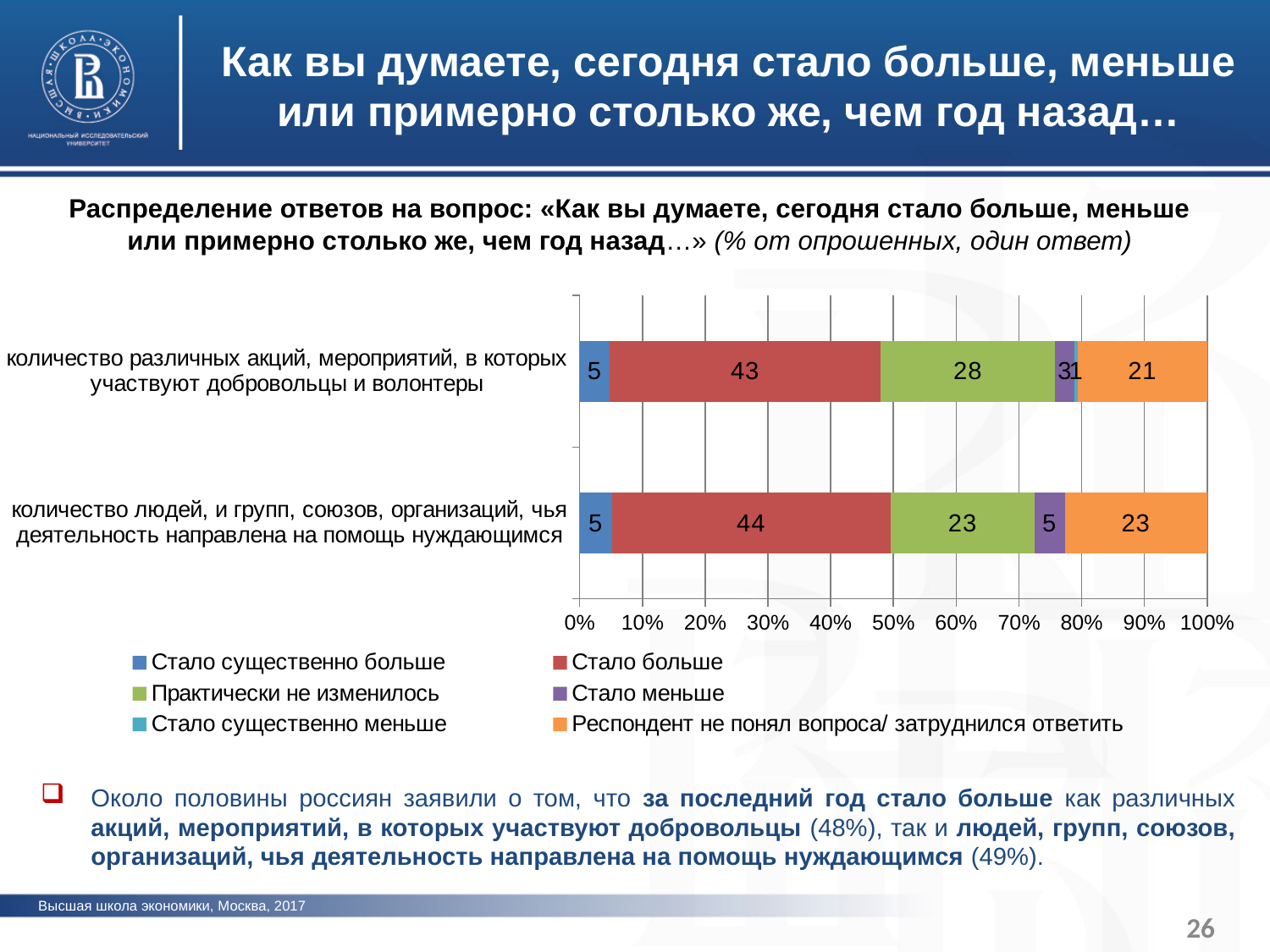
What is the value for «Стало меньше» for the category «количество людей, и групп, союзов, организаций, чья деятельность направлена на помощь нуждающимся»? 5 What is the value for «Стало существенно больше» for the category «количество людей, и групп, союзов, организаций, чья деятельность направлена на помощь нуждающимся»? 5 What is the difference between the «Практически не изменилось» values for the two categories? 5 What is the value for «Стало больше» for the category «количество различных акций, мероприятий, в которых участвуют добровольцы и волонтеры»? 43 What is the value for «Практически не изменилось» for the category «количество различных акций, мероприятий, в которых участвуют добровольцы и волонтеры»? 28 What is the value for «Практически не изменилось» for the category «количество людей, и групп, союзов, организаций, чья деятельность направлена на помощь нуждающимся»? 23 What is the value for «Респондент не понял вопроса/ затруднился ответить» for the category «количество различных акций, мероприятий, в которых участвуют добровольцы и волонтеры»? 21 Which answer option has the largest share for the category «количество различных акций, мероприятий, в которых участвуют добровольцы и волонтеры»? Стало больше How many series does the legend list? 6 What is the value for «Стало больше» for the category «количество людей, и групп, союзов, организаций, чья деятельность направлена на помощь нуждающимся»? 44 What kind of chart is shown on the slide? Stacked bar chart Which category has the larger value for «Стало больше»? количество людей, и групп, союзов, организаций, чья деятельность направлена на помощь нуждающимся